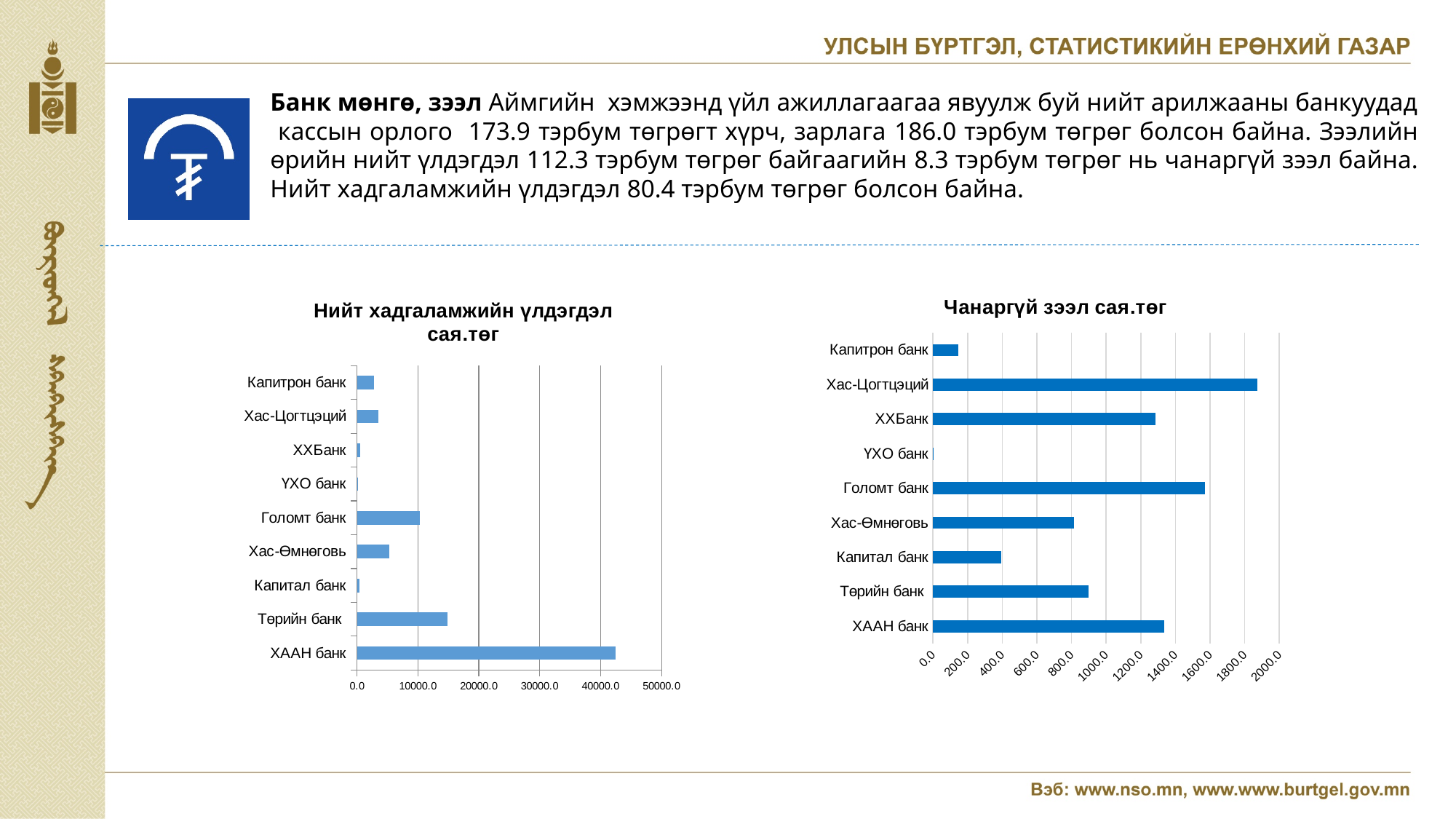
In the left chart 'Нийт хадгаламжийн үлдэгдэл сая.төг', which bank has the highest value? ХААН банк In the left chart 'Нийт хадгаламжийн үлдэгдэл сая.төг', is the value for Төрийн банк greater or less than 20000.0? less In the left chart 'Нийт хадгаламжийн үлдэгдэл сая.төг', is the value for ХААН банк greater or less than 40000.0? greater How many banks are shown in the right chart 'Чанаргүй зээл сая.төг'? 9 In the right chart 'Чанаргүй зээл сая.төг', is the value for Голомт банк greater or less than 1400.0? greater In the right chart 'Чанаргүй зээл сая.төг', which is larger, the value for Төрийн банк or the value for Капитал банк? Төрийн банк What kind of chart is the left chart titled 'Нийт хадгаламжийн үлдэгдэл сая.төг'? bar chart What is the title of the right chart on the slide? Чанаргүй зээл сая.төг In the right chart 'Чанаргүй зээл сая.төг', which bank has the lowest value? ҮХО банк How many banks are shown in the left chart 'Нийт хадгаламжийн үлдэгдэл сая.төг'? 9 In the right chart 'Чанаргүй зээл сая.төг', which bank has the highest value? Хас-Цогтцэций In the left chart 'Нийт хадгаламжийн үлдэгдэл сая.төг', which is larger, the value for Голомт банк or the value for Хас-Өмнөговь? Голомт банк